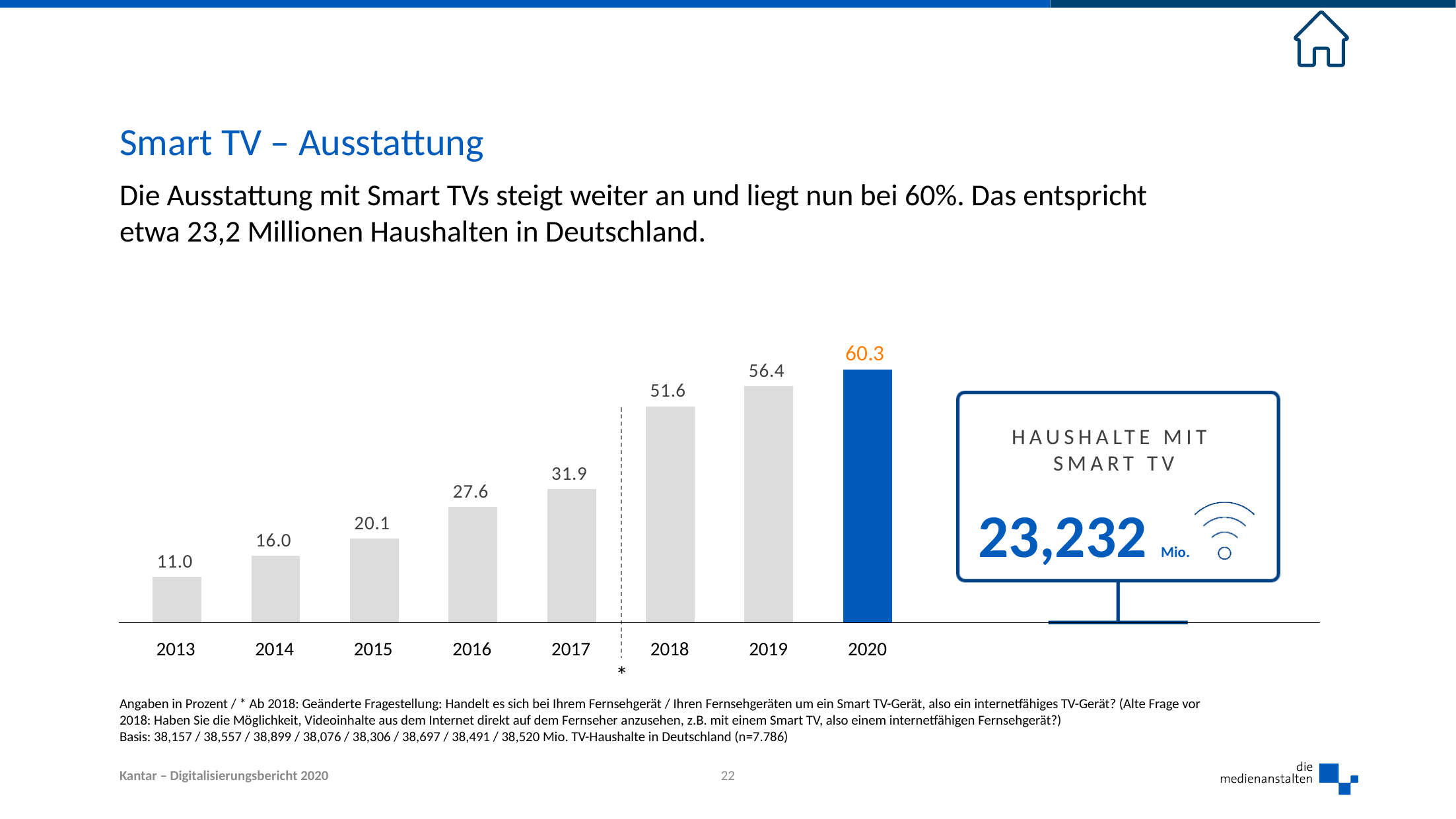
What kind of chart is this? bar chart Which is larger, the value for 2016 or the value for 2015? 2016 What is the difference between the values for 2020 and 2019? 3.9 What is the value for 2013? 11.0 What is the value for 2020? 60.3 What is the difference between the values for 2018 and 2017? 19.7 How many years are shown on the x axis? 8 Which year has the highest value? 2020 Which bar is highlighted in blue rather than grey? 2020 What is the value for 2017? 31.9 Do the values rise or fall from 2013 to 2020? rise Which year has the lowest value? 2013